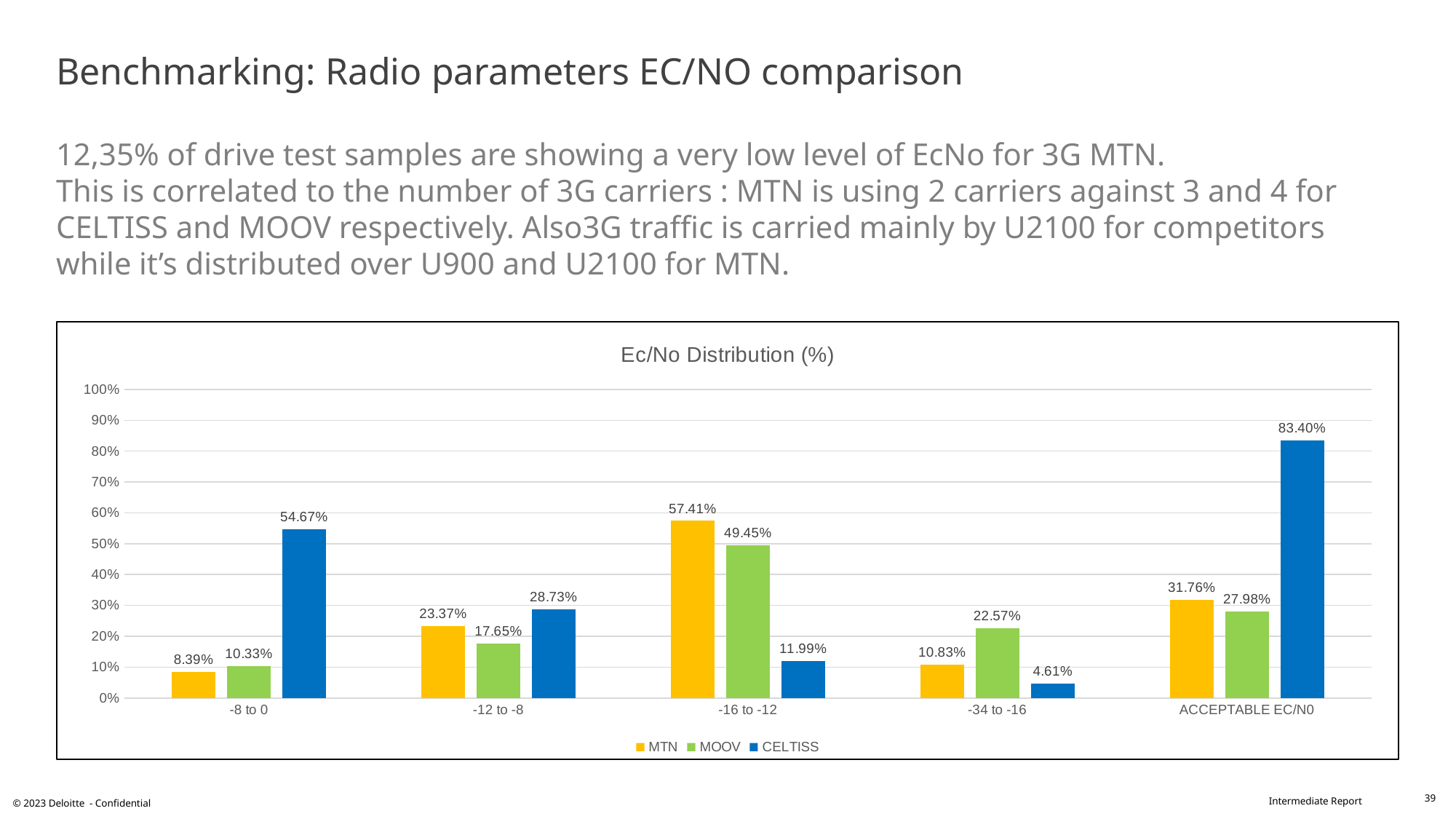
What is the title of the chart? Ec/No Distribution (%) Is the value for CELTISS in the -8 to 0 category greater or less than 50%? greater What is the difference between the MTN and MOOV values in the -16 to -12 category? 7.96% How many categories are shown on the x axis? 5 Which series has the lowest value in the -34 to -16 category? CELTISS Which series has the highest value in the -8 to 0 category? CELTISS What is the value for MTN in the -16 to -12 category? 57.41% How many series does the legend list? 3 What is the value for CELTISS in the ACCEPTABLE EC/N0 category? 83.40% Which is larger in the -12 to -8 category, MTN or MOOV? MTN What kind of chart is shown on the slide? Bar chart What is the value for MOOV in the -34 to -16 category? 22.57%